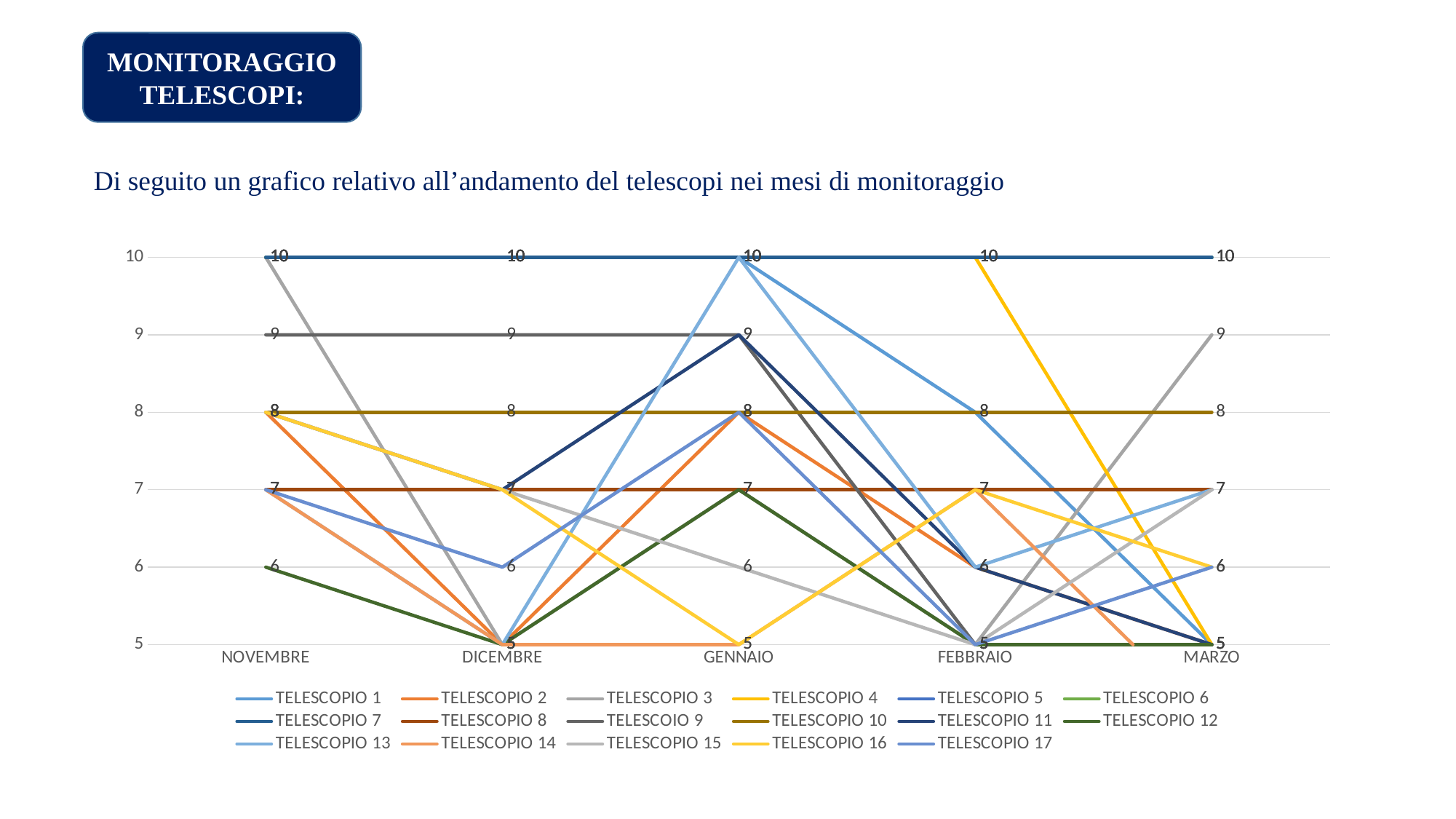
Which month comes between DICEMBRE and FEBBRAIO on the x axis? GENNAIO What is the lowest value shown on the y axis? 5 What kind of chart is shown on the slide? line chart How many series does the chart's legend list? 17 What is the first month shown on the x axis? NOVEMBRE How many months are shown on the x axis of the chart? 5 What is the last month shown on the x axis? MARZO What is the highest data value reached by any series in the chart? 10 What is the highest value shown on the y axis? 10 What value does the topmost horizontal line hold in every month from NOVEMBRE to MARZO? 10